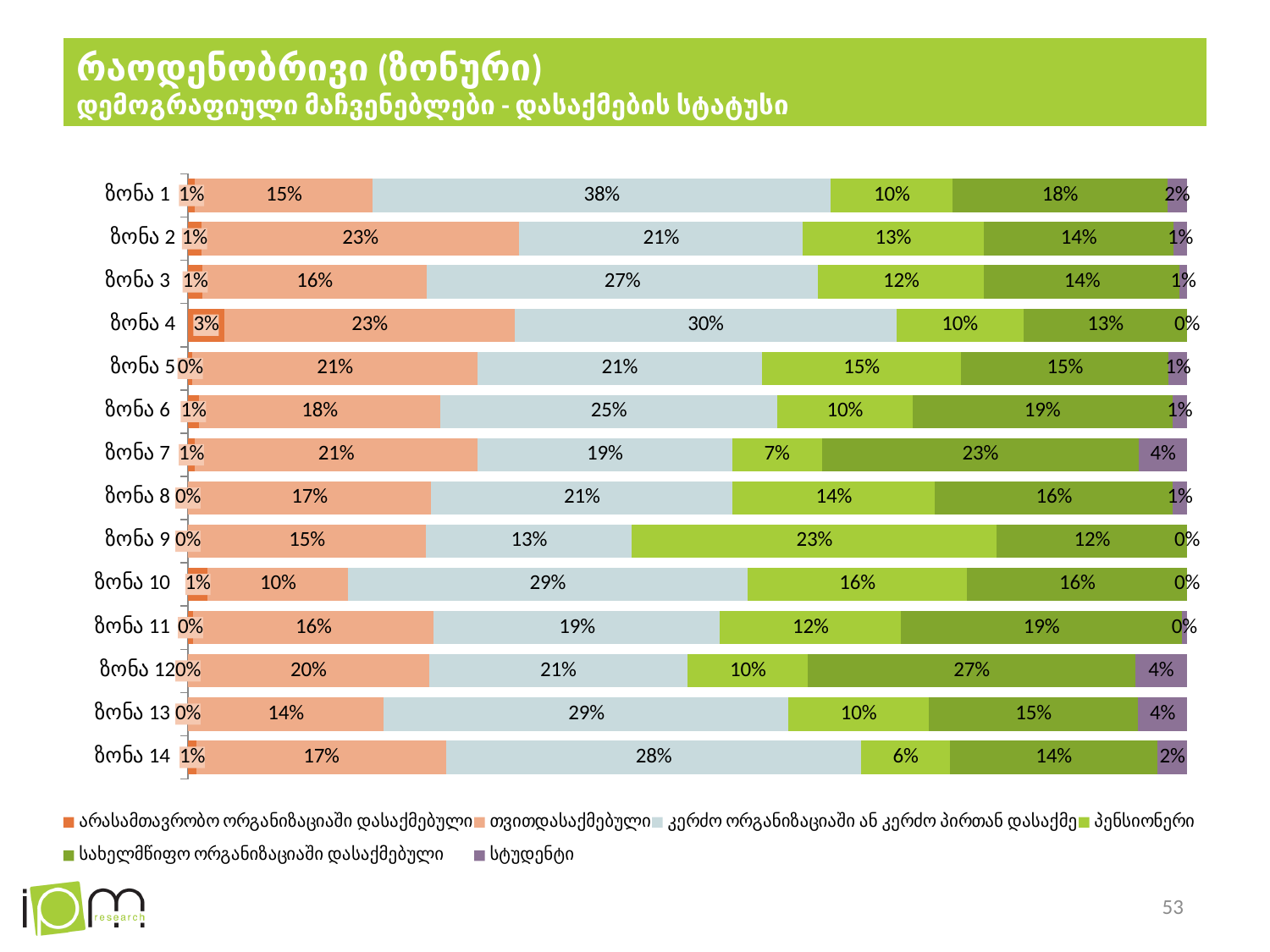
What is the value for ზონა 1 in the კერძო ორგანიზაციაში ან კერძო პირთან დასაქმებული series? 38% Which zone has the highest value in the სახელმწიფო ორგანიზაციაში დასაქმებული series? ზონა 12 What is the difference between the თვითდასაქმებული values for ზონა 2 and ზონა 1? 8 percentage points Which zone has the highest value in the კერძო ორგანიზაციაში ან კერძო პირთან დასაქმებული series? ზონა 1 What is the value for ზონა 12 in the სახელმწიფო ორგანიზაციაში დასაქმებული series? 27% Which has the larger სახელმწიფო ორგანიზაციაში დასაქმებული value, ზონა 7 or ზონა 6? ზონა 7 What kind of chart is shown on the slide? Stacked bar chart Which zone has the lowest თვითდასაქმებული value? ზონა 10 How many series does the legend list? 6 What is the პენსიონერი value for ზონა 9? 23% How many zones are shown on the chart? 14 What is the პენსიონერი value for ზონა 14? 6%